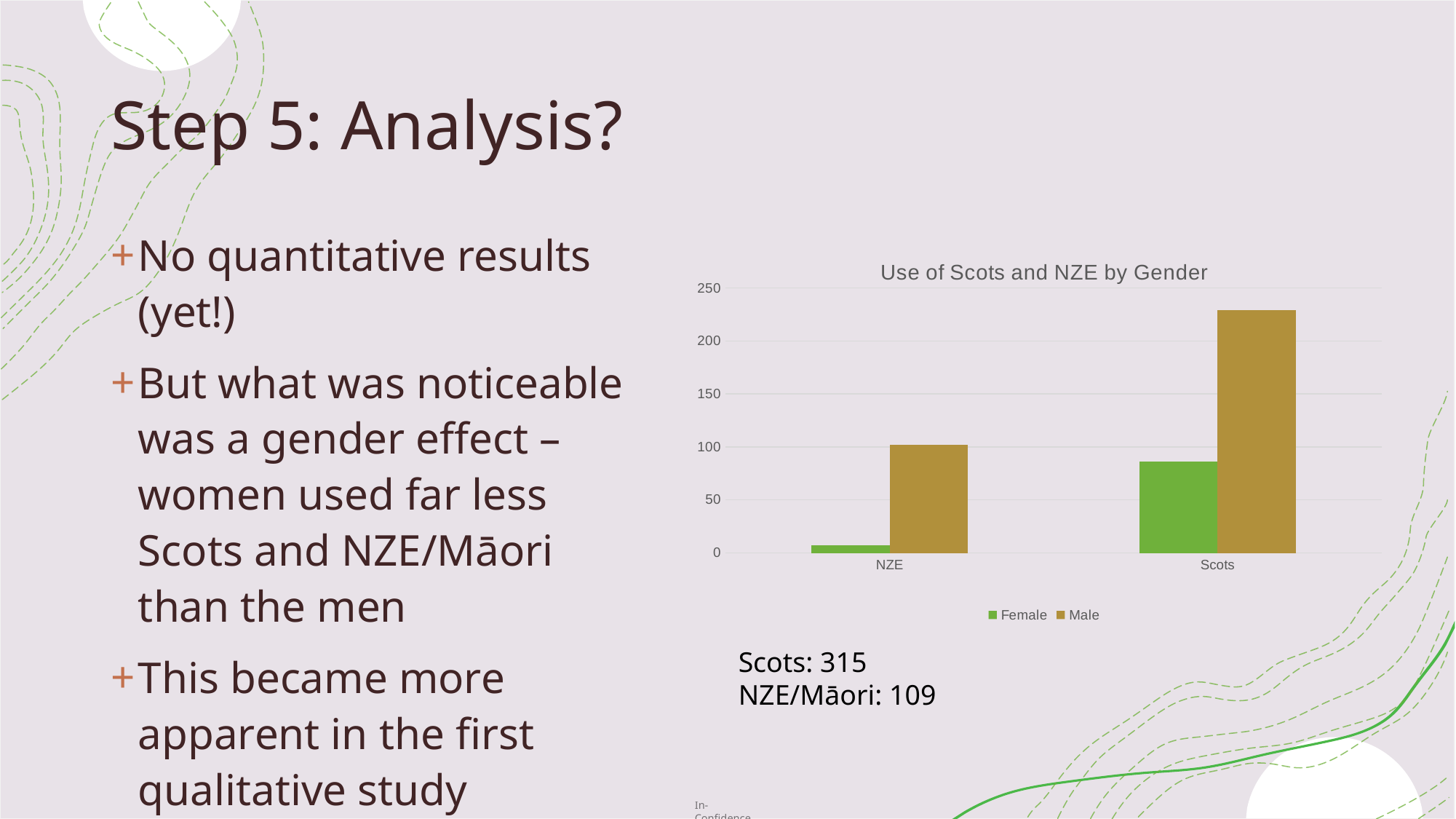
How many categories are shown on the x axis of the chart? 2 How many series does the chart legend list? 2 Which series is shown in green in the chart? Female Which is larger: the Male value for NZE or the Male value for Scots? Scots What type of chart is shown on the slide? bar chart Is the Male value for Scots greater or less than 200? greater Is the Female value for Scots greater or less than 100? less What is the title of the chart? Use of Scots and NZE by Gender For the Scots category, which is larger: the Female value or the Male value? Male Which category has the lowest Female value in the chart? NZE Is the Female value for NZE greater or less than 50? less Which category has the highest Male value in the chart? Scots